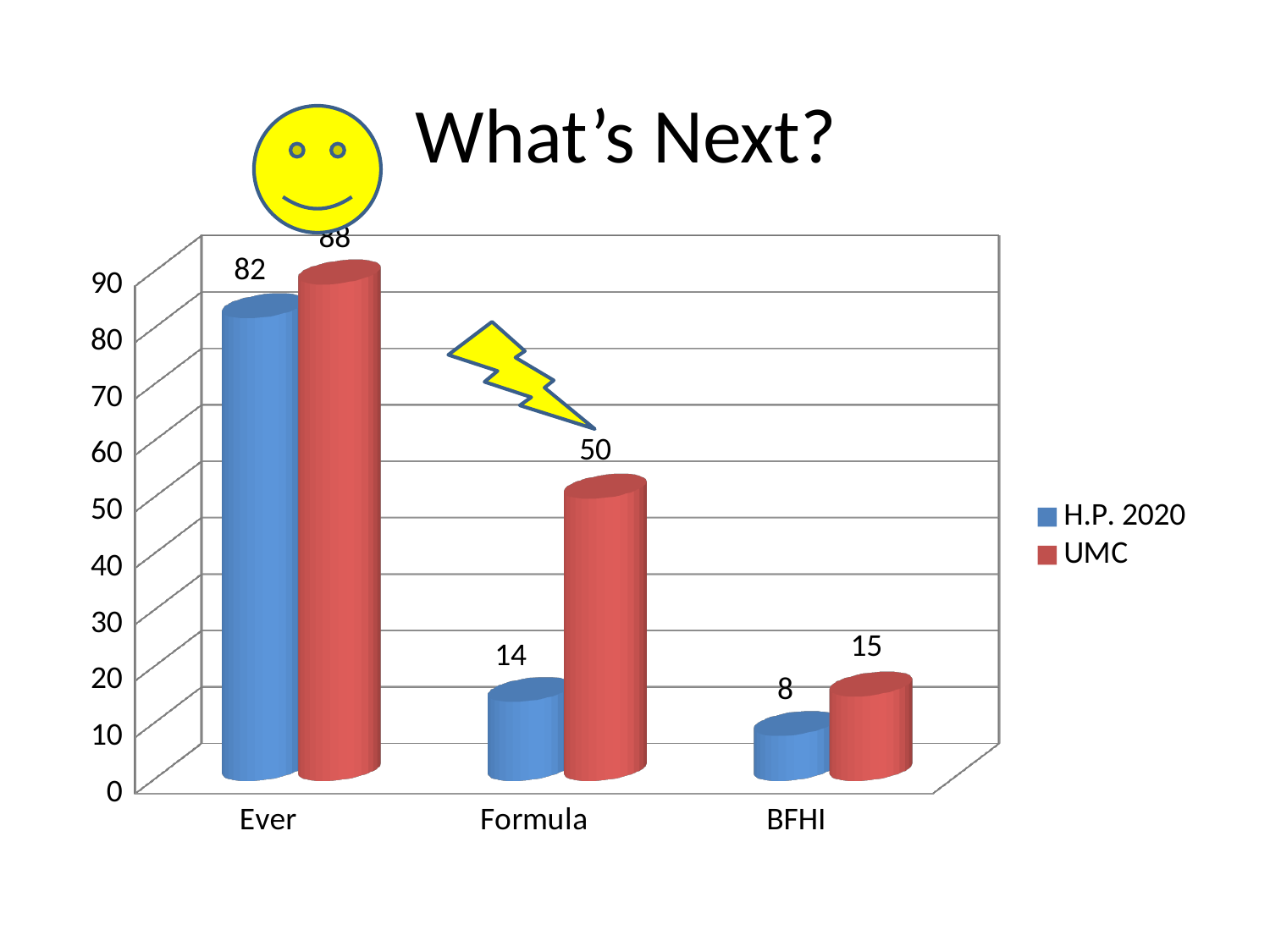
What is the UMC value for BFHI? 15 Which is larger for Ever, the H.P. 2020 value or the UMC value? UMC How many categories are shown on the x axis? 3 What kind of chart is shown on the slide? bar chart Which category has the lowest H.P. 2020 value? BFHI What is the difference between the UMC and H.P. 2020 values for Formula? 36 What is the UMC value for Formula? 50 What is the H.P. 2020 value for Ever? 82 Is the UMC value for Formula greater or less than 40? greater How many series does the legend list? 2 Which category has the highest UMC value? Ever What is the H.P. 2020 value for BFHI? 8